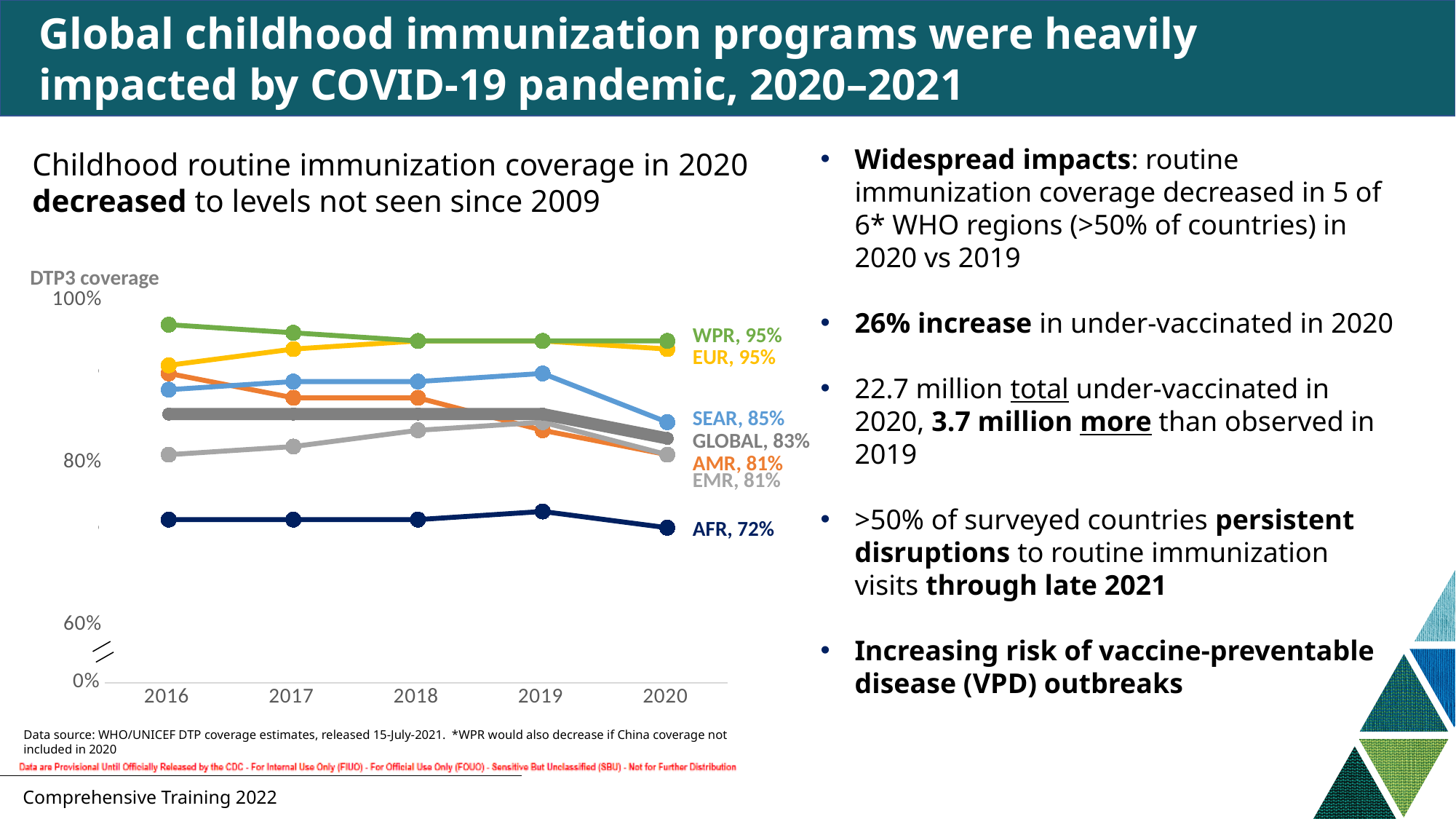
How many regional/global series are labelled on the DTP3 coverage chart? 7 What is the DTP3 coverage value labelled for AFR in 2020? 72% What is the DTP3 coverage value labelled for WPR in 2020? 95% Does the SEAR DTP3 coverage rise or fall from 2019 to 2020? fall In 2020, which is higher: SEAR or GLOBAL DTP3 coverage? SEAR How many years are shown on the x axis of the DTP3 coverage chart? 5 What kind of chart is used to show DTP3 coverage? line chart Which region has the lowest DTP3 coverage in 2020? AFR Is the DTP3 coverage for AFR in 2016 greater or less than 80%? less What is the GLOBAL DTP3 coverage value labelled for 2020? 83% Is the DTP3 coverage for WPR in 2016 greater or less than 80%? greater What is the difference between the 2020 DTP3 coverage for SEAR and AFR? 13 percentage points